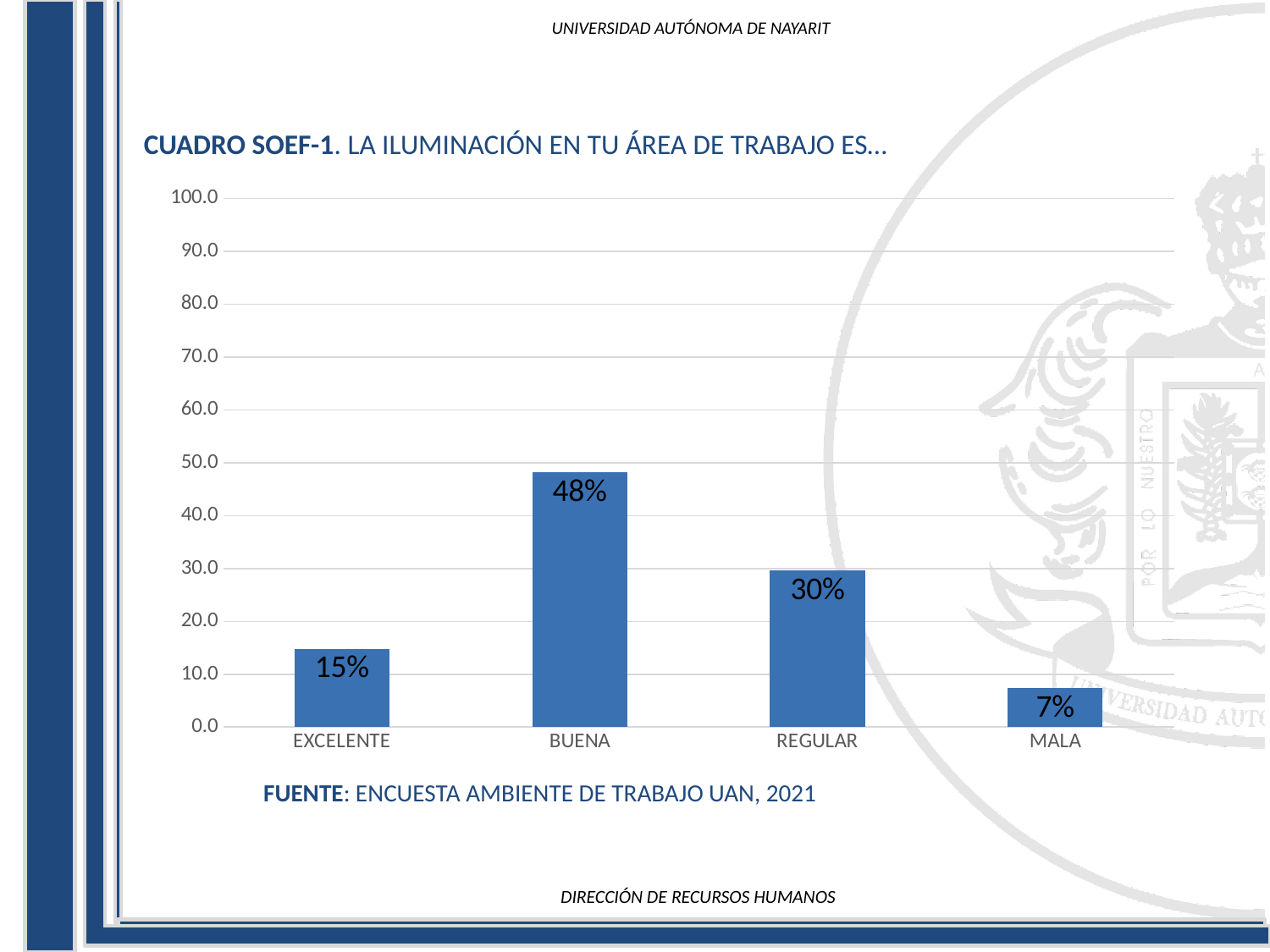
How many categories are shown on the x axis? 4 What is the value for MALA? 7% What source is cited below the chart? ENCUESTA AMBIENTE DE TRABAJO UAN, 2021 What is the difference between the values for BUENA and REGULAR? 18% What is the value for BUENA? 48% What kind of chart is shown on the slide? Bar chart Which is larger, the value for EXCELENTE or the value for MALA? EXCELENTE What is the value for REGULAR? 30% Which category has the highest value? BUENA Which category has the lowest value? MALA Is the value for REGULAR greater or less than 20.0? greater What is the value for EXCELENTE? 15%